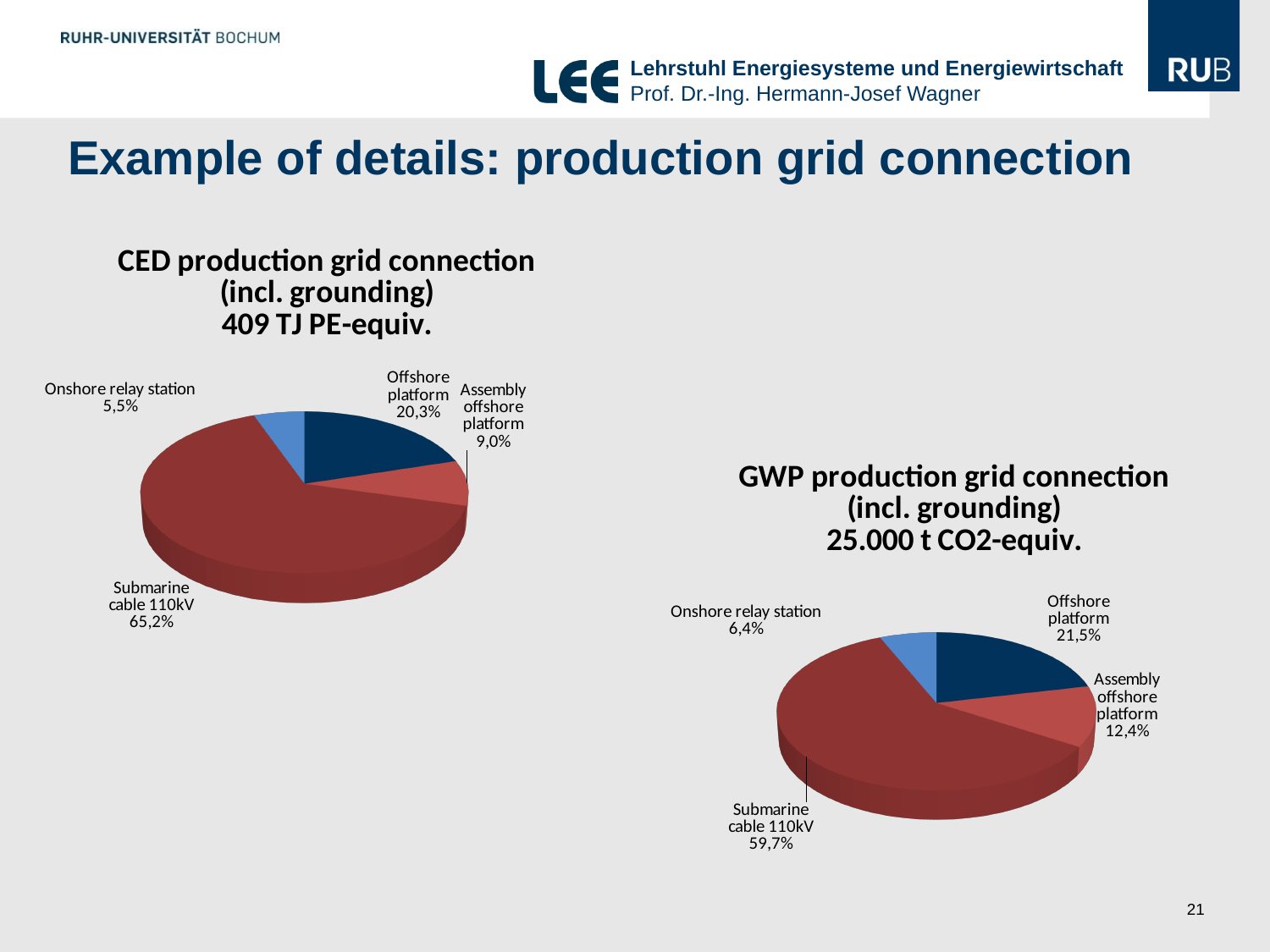
In the CED production grid connection pie chart, what is the difference in percentage points between Offshore platform and Assembly offshore platform? 11,3 In the GWP production grid connection pie chart, which is larger: Offshore platform or Assembly offshore platform? Offshore platform What total value is stated in the title of the CED production grid connection chart? 409 TJ PE-equiv. In the GWP production grid connection pie chart, what share does Onshore relay station have? 6,4% What total value is stated in the title of the GWP production grid connection chart? 25.000 t CO2-equiv. In the CED production grid connection pie chart, what share does Offshore platform have? 20,3% In the CED production grid connection pie chart, which category has the smallest share? Onshore relay station In the GWP production grid connection pie chart, what share does Assembly offshore platform have? 12,4% In the GWP production grid connection pie chart, which category has the largest share? Submarine cable 110kV In the CED production grid connection pie chart, how many slices are there? 4 What kind of chart is the GWP production grid connection chart? Pie chart